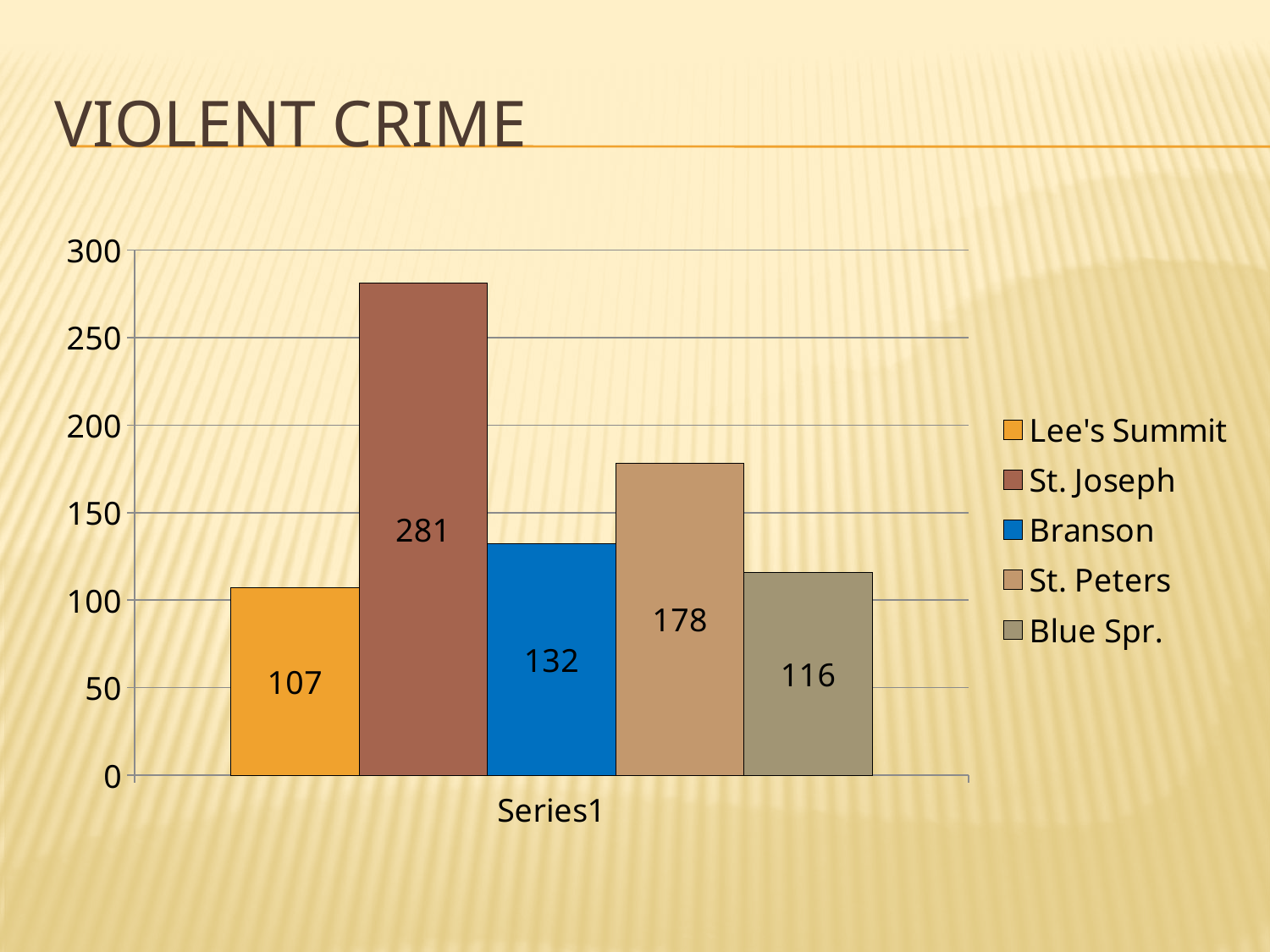
What is the title of the slide? VIOLENT CRIME What is the difference between the values for Branson and Blue Spr.? 16 Which is larger, the value for Branson or the value for Blue Spr.? Branson What is the value for St. Peters? 178 What kind of chart is shown on the slide? bar chart Is the value for St. Peters greater or less than 150? greater What is the difference between the values for St. Joseph and St. Peters? 103 How many cities are shown in the chart? 5 Which city has the lowest value? Lee's Summit What is the value for St. Joseph? 281 What is the value for Lee's Summit? 107 Which city has the highest value? St. Joseph